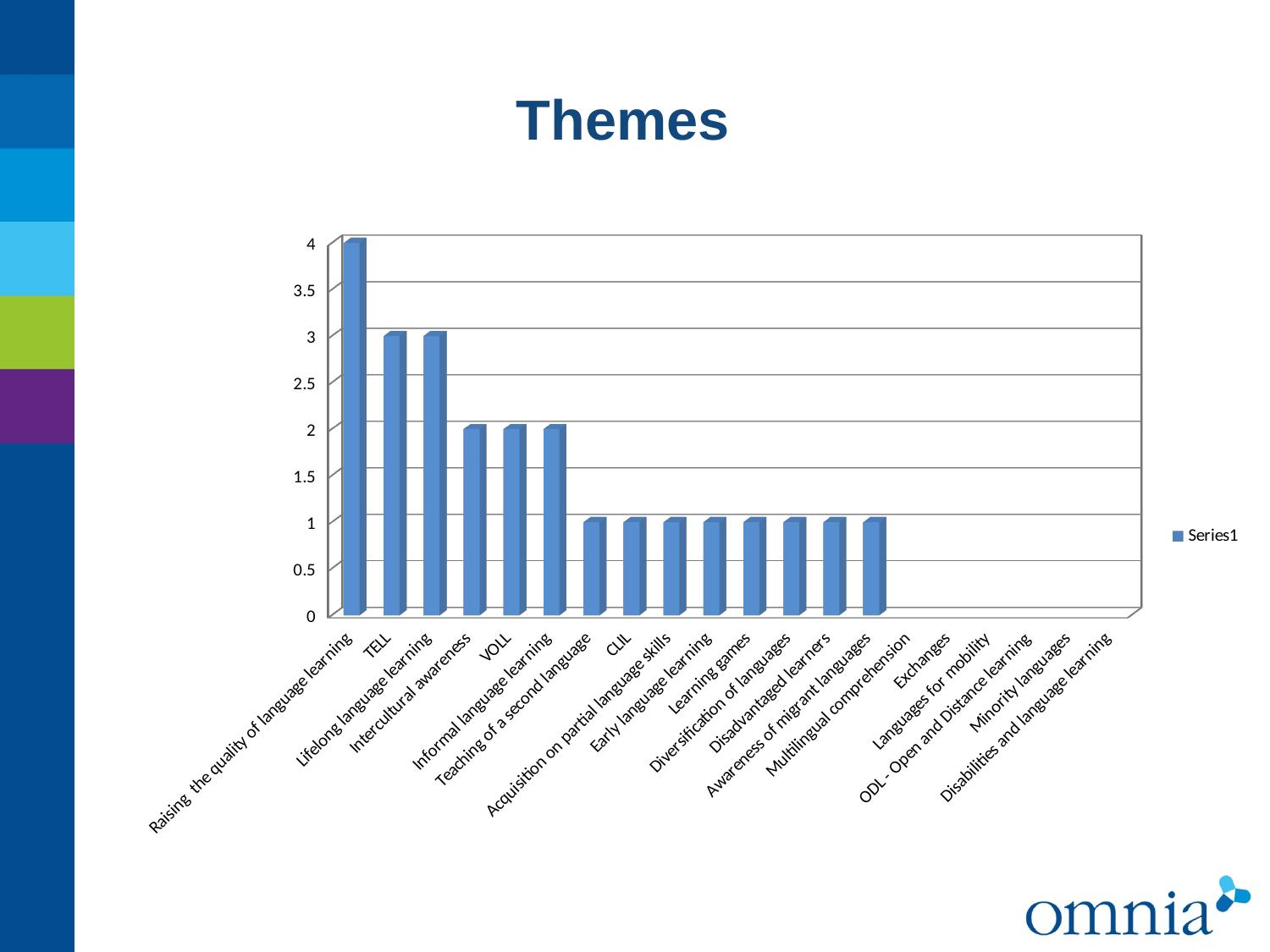
What is the value for Raising the quality of language learning? 4 Which category has the highest value? Raising the quality of language learning What is the title of the chart? Themes How many series does the legend list? 1 What is the difference between the values for Raising the quality of language learning and Lifelong language learning? 1 What type of chart is shown on the slide? bar chart Do the values generally rise or fall from left to right along the x axis? fall What is the value for TELL? 3 What is the value for CLIL? 1 Which is larger, the value for VOLL or the value for Learning games? VOLL How many categories are shown on the x axis? 20 What is the value for Intercultural awareness? 2